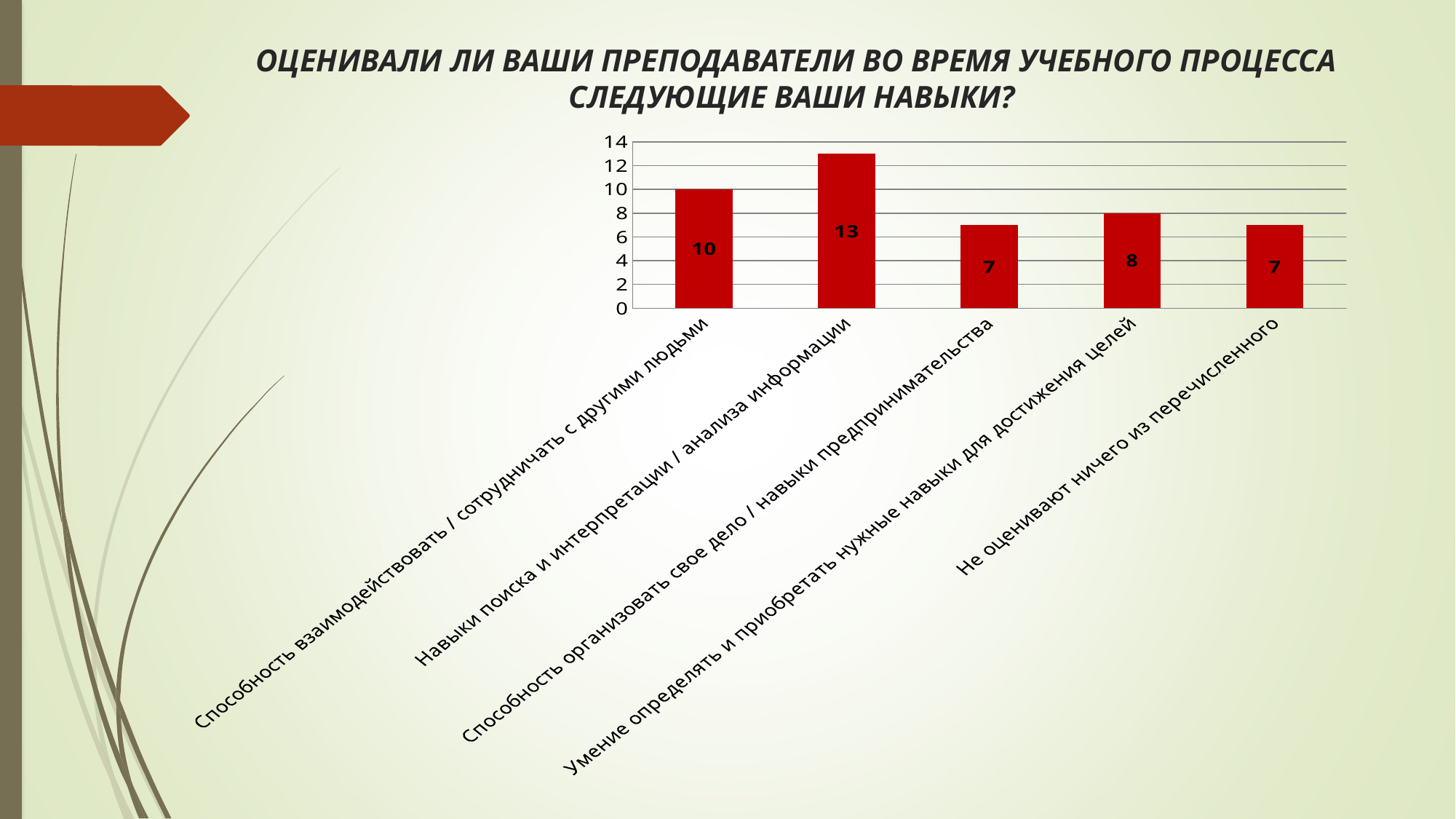
What is the maximum value shown on the vertical axis? 14 Which is larger: the value for 'Способность взаимодействовать / сотрудничать с другими людьми' or the value for 'Умение определять и приобретать нужные навыки для достижения целей'? Способность взаимодействовать / сотрудничать с другими людьми What is the value for 'Навыки поиска и интерпретации / анализа информации'? 13 What is the value for 'Не оценивают ничего из перечисленного'? 7 What kind of chart is shown on the slide? bar chart What is the value for 'Умение определять и приобретать нужные навыки для достижения целей'? 8 What is the value for 'Способность взаимодействовать / сотрудничать с другими людьми'? 10 Is the value for 'Способность организовать свое дело / навыки предпринимательства' greater or less than 10? less How many categories are shown on the chart? 5 What is the difference between the values for 'Навыки поиска и интерпретации / анализа информации' and 'Способность взаимодействовать / сотрудничать с другими людьми'? 3 What colour are the bars in the chart? red Which category has the highest value? Навыки поиска и интерпретации / анализа информации